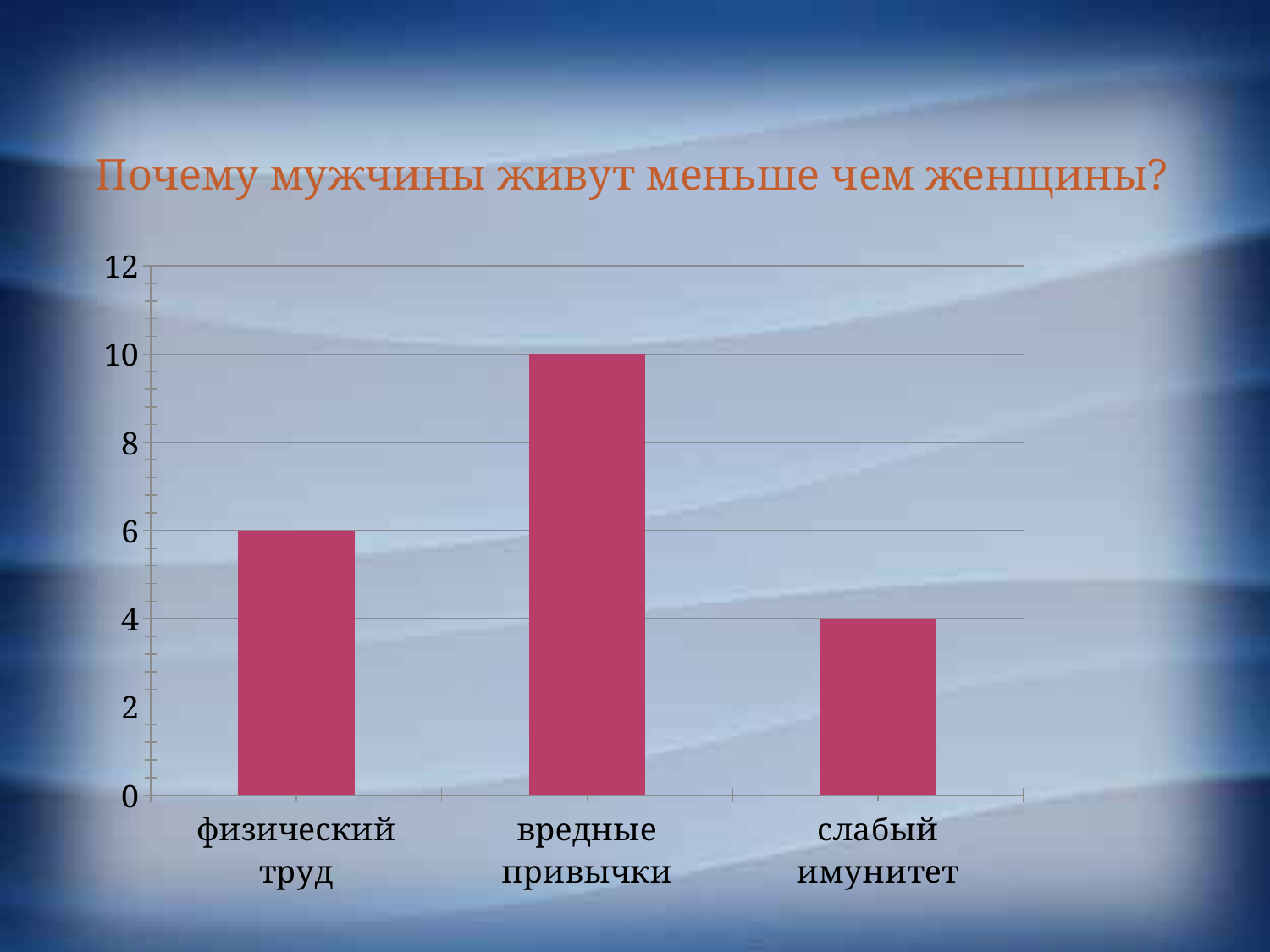
What is the value for вредные привычки? 10 Which category has the lowest value? слабый имунитет Which is larger, the value for физический труд or the value for слабый имунитет? физический труд Is the value for вредные привычки greater or less than 8? greater What kind of chart is shown on the slide? bar chart How many categories are shown on the x axis? 3 What is the difference between the values for физический труд and слабый имунитет? 2 What is the value for физический труд? 6 What is the title shown above the chart? Почему мужчины живут меньше чем женщины? What is the value for слабый имунитет? 4 Which category has the highest value? вредные привычки What is the difference between the values for вредные привычки and физический труд? 4